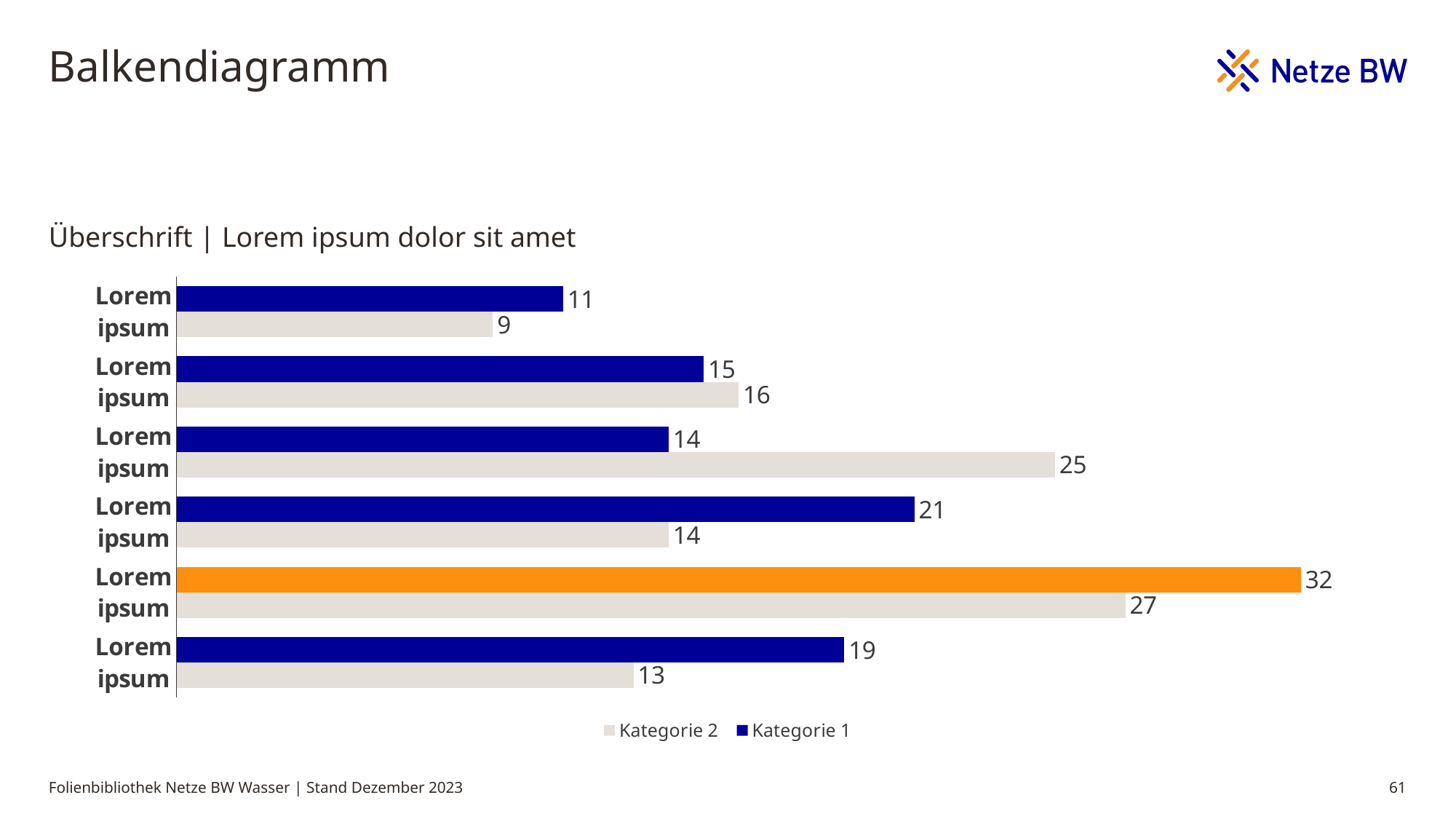
What is the Kategorie 2 value for the third category from the top? 25 For the third category from the top, which is larger: the Kategorie 1 value or the Kategorie 2 value? Kategorie 2 What is the Kategorie 2 value for the bottom category? 13 How many categories are plotted on the chart? 6 What is the difference between the Kategorie 1 and Kategorie 2 values for the fifth category from the top? 5 What is the lowest Kategorie 2 value shown on the chart? 9 What is the highest Kategorie 1 value shown on the chart? 32 What is the Kategorie 1 value for the topmost category? 11 Which series is shown in grey according to the legend? Kategorie 2 What kind of chart is shown on the slide? bar chart How many series does the legend list? 2 What is the title of the chart? Überschrift | Lorem ipsum dolor sit amet